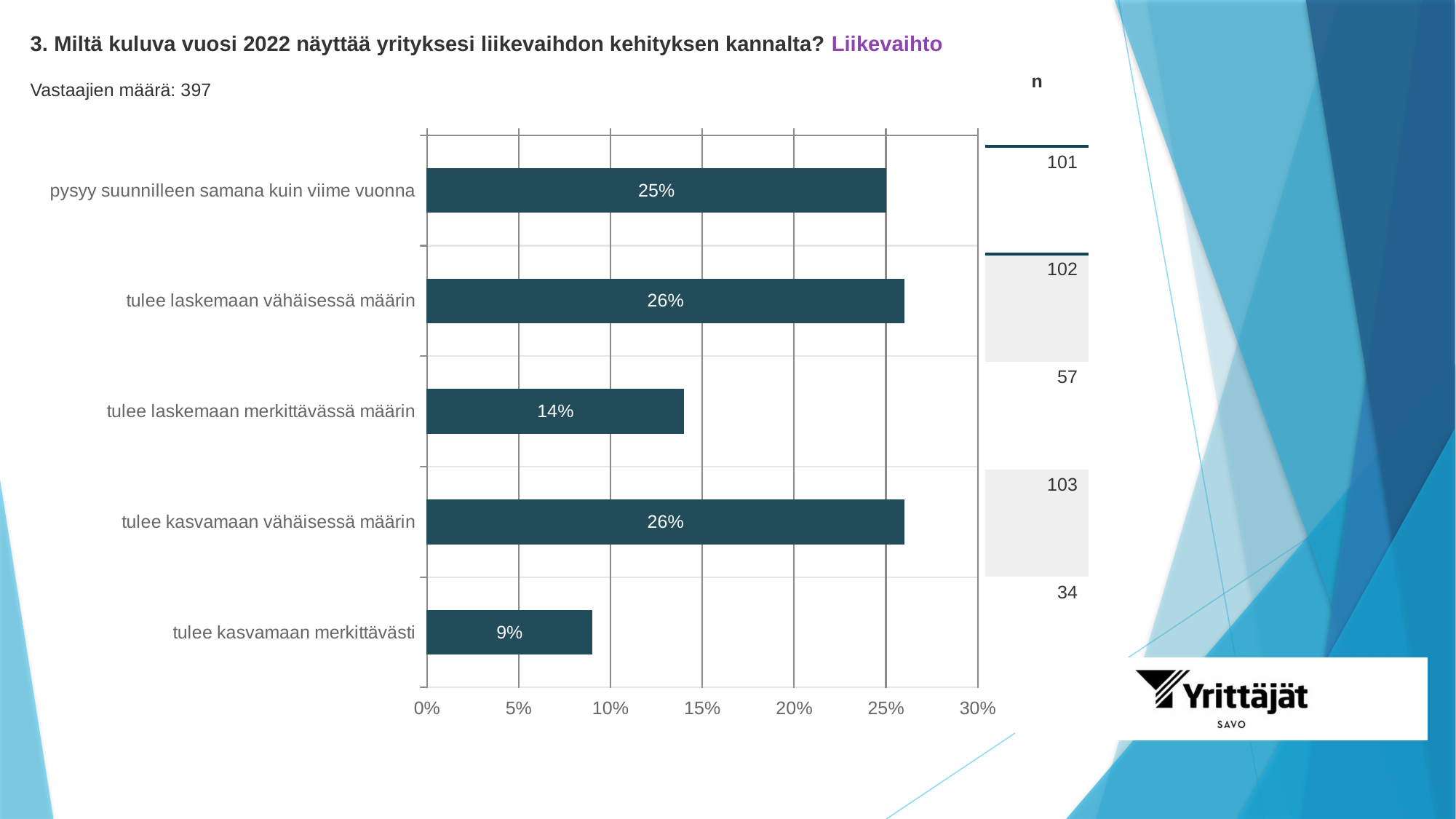
Is the value for "tulee kasvamaan merkittävästi" greater or less than 10%? less How many categories does the bar chart show? 5 What is the value for "tulee kasvamaan merkittävästi"? 9% What is the value for "tulee laskemaan merkittävässä määrin"? 14% What is the number of respondents (n) shown for "tulee laskemaan merkittävässä määrin"? 57 What is the total number of respondents (Vastaajien määrä) stated on the slide? 397 What is the value for "pysyy suunnilleen samana kuin viime vuonna"? 25% Which is larger, the value for "tulee laskemaan merkittävässä määrin" or the value for "tulee kasvamaan merkittävästi"? tulee laskemaan merkittävässä määrin What is the value for "tulee kasvamaan vähäisessä määrin"? 26% What kind of chart is shown on the slide? bar chart Which category has the lowest value? tulee kasvamaan merkittävästi What is the difference between the values for "tulee laskemaan vähäisessä määrin" and "tulee laskemaan merkittävässä määrin"? 12%